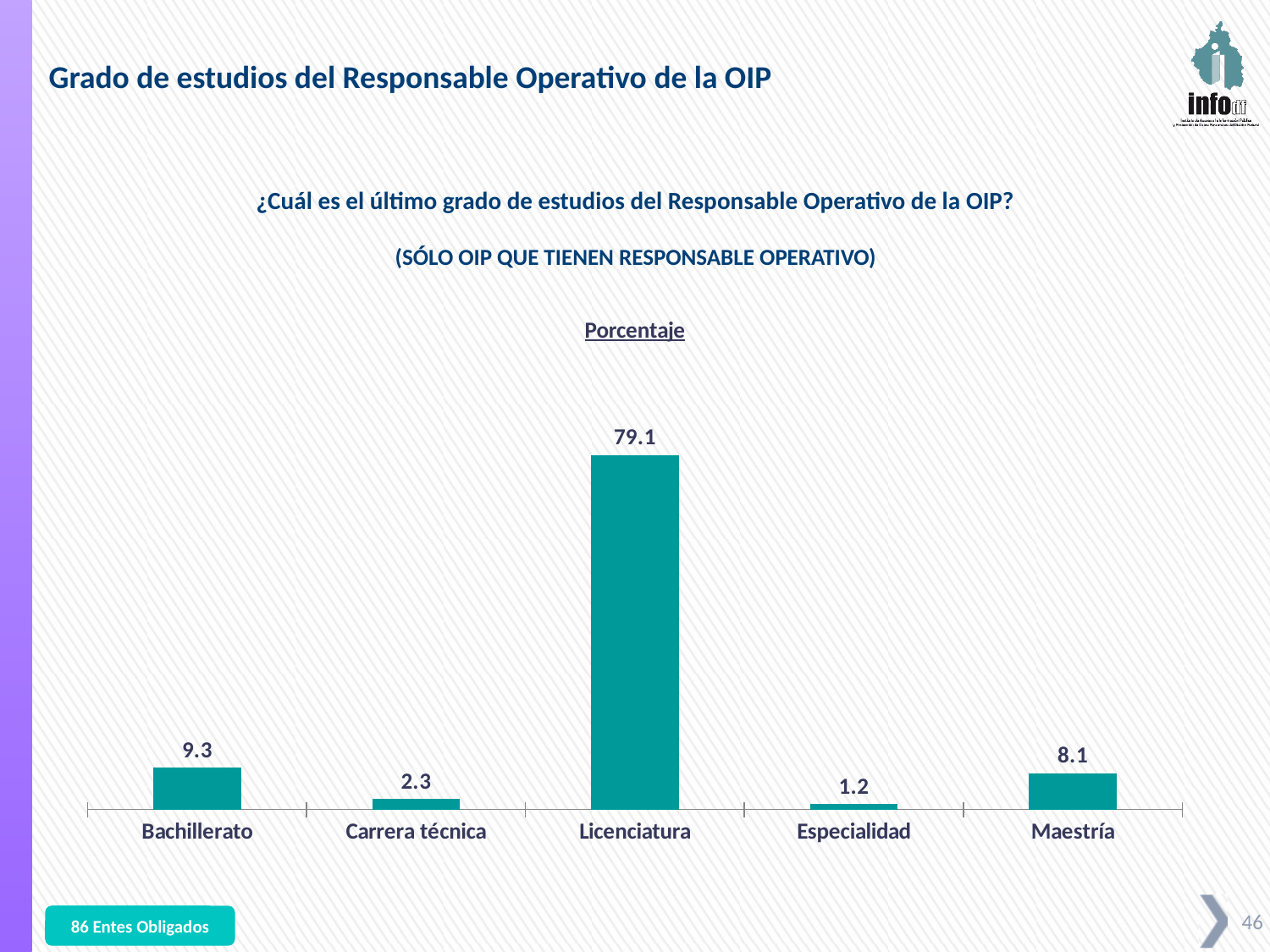
What kind of chart is shown on the slide? Bar chart What is the difference between the values for Bachillerato and Maestría? 1.2 Which category has the highest value? Licenciatura Which category has the lowest value? Especialidad How many categories are shown on the x axis? 5 What is the title of the chart? Porcentaje What is the value for Licenciatura? 79.1 What is the value for Maestría? 8.1 What is the difference between the values for Licenciatura and Bachillerato? 69.8 What is the value for Bachillerato? 9.3 What is the value for Especialidad? 1.2 Which is larger, the value for Carrera técnica or the value for Maestría? Maestría